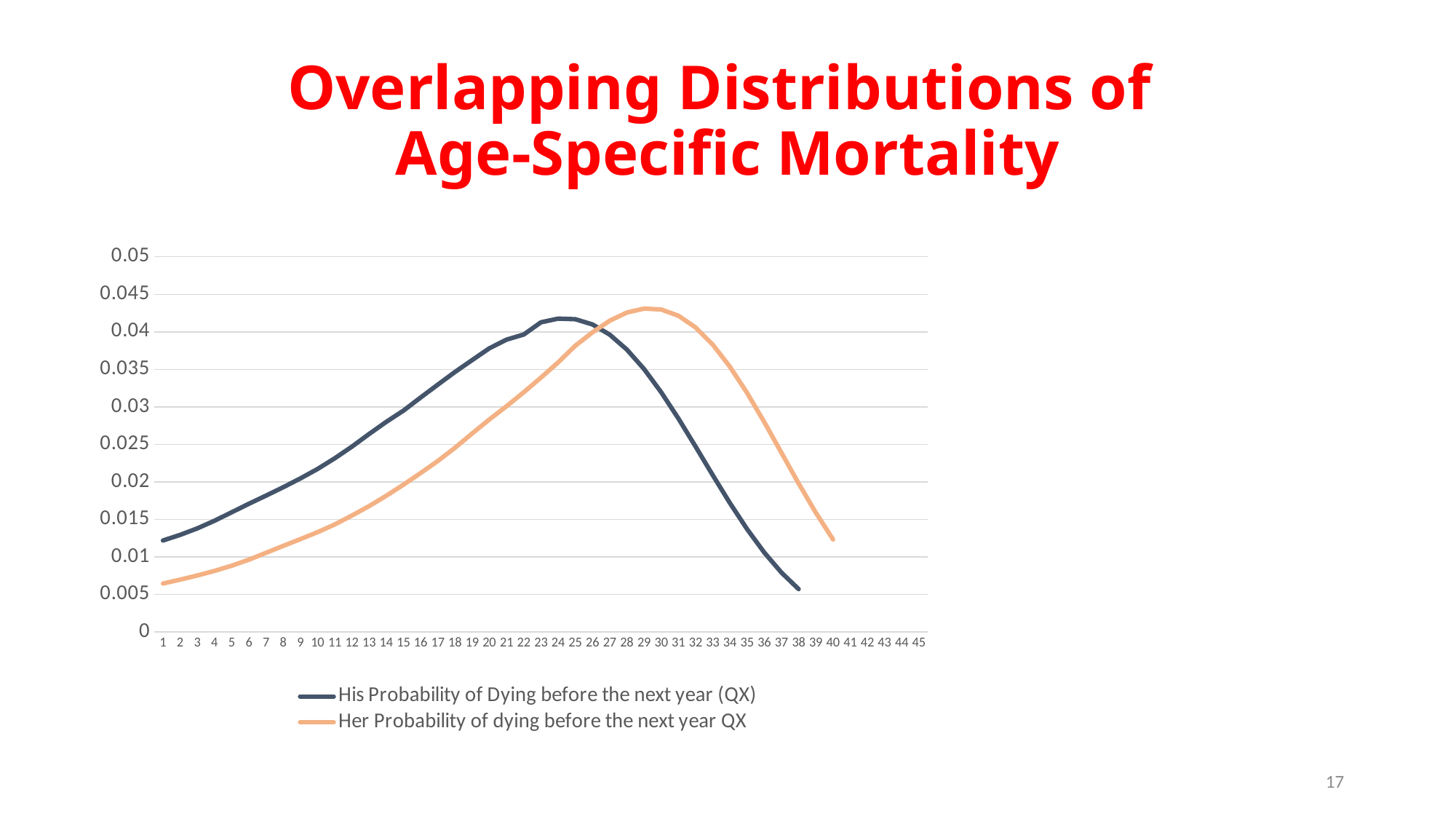
What is the label of the dark blue series in the legend? His Probability of Dying before the next year (QX) How many series does the legend list? 2 Is the value of the 'Her Probability of dying before the next year QX' series at x = 1 greater or less than 0.01? less How many categories are labelled on the x axis? 45 What is the label of the orange series in the legend? Her Probability of dying before the next year QX Is the value of the 'His Probability of Dying before the next year (QX)' series at x = 38 greater or less than 0.01? less Does the 'His Probability of Dying before the next year (QX)' series rise or fall between x = 1 and x = 20? rise Is the value of the 'His Probability of Dying before the next year (QX)' series at x = 1 greater or less than 0.01? greater What kind of chart is shown on the slide? line chart Which series reaches its peak further to the right along the x axis? Her Probability of dying before the next year QX